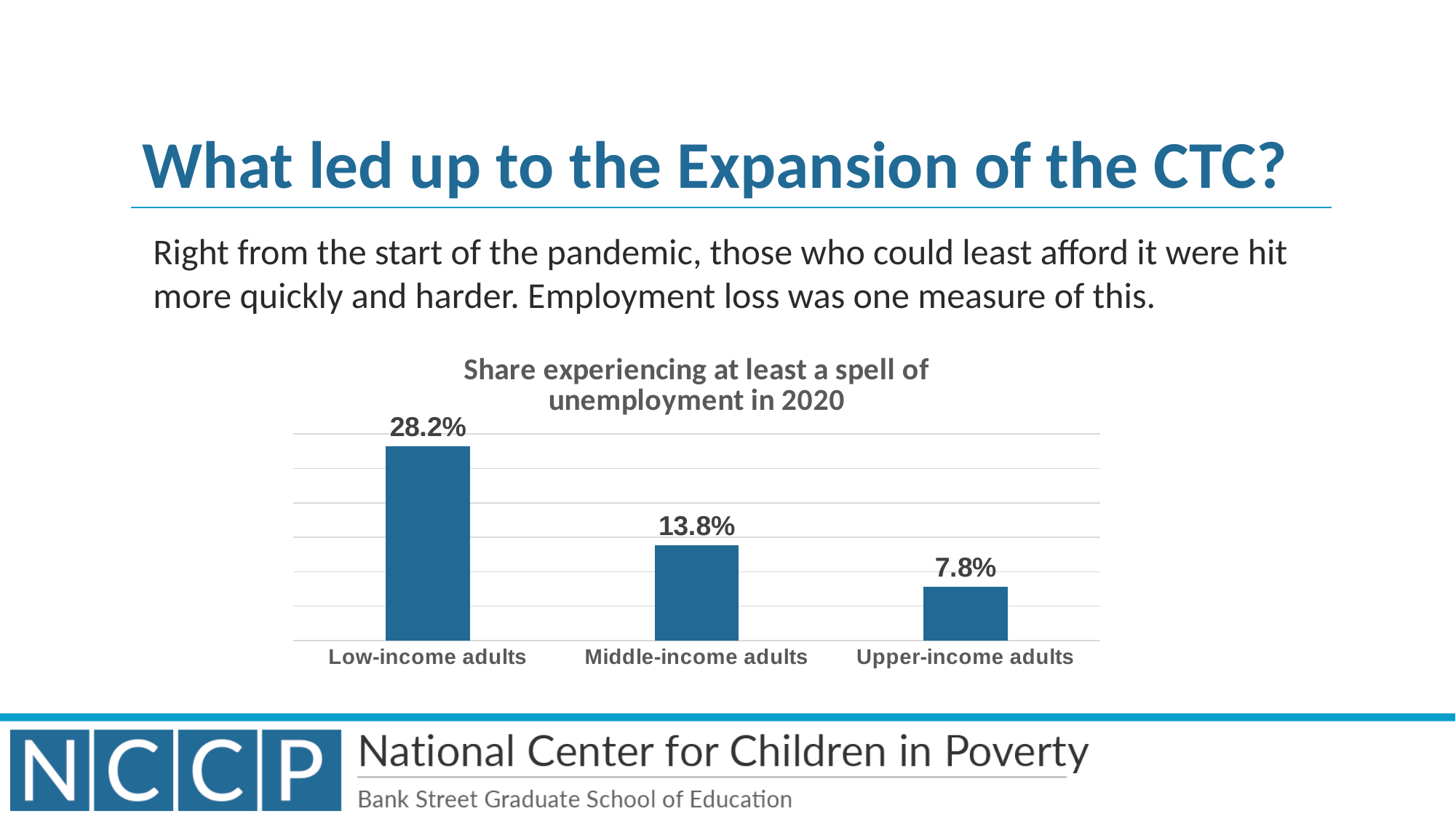
Which is larger, the value for Middle-income adults or the value for Upper-income adults? Middle-income adults What is the difference between the values for Low-income adults and Middle-income adults? 14.4% What kind of chart is shown on the slide? Bar chart What is the value for Middle-income adults? 13.8% Which category has the lowest share experiencing at least a spell of unemployment in 2020? Upper-income adults What is the value for Upper-income adults? 7.8% Do the values rise or fall moving from Low-income adults to Upper-income adults along the x axis? Fall Which category has the highest share experiencing at least a spell of unemployment in 2020? Low-income adults What is the difference between the values for Middle-income adults and Upper-income adults? 6.0% What is the value for Low-income adults? 28.2% What is the title of the chart? Share experiencing at least a spell of unemployment in 2020 How many categories are shown in the chart? 3